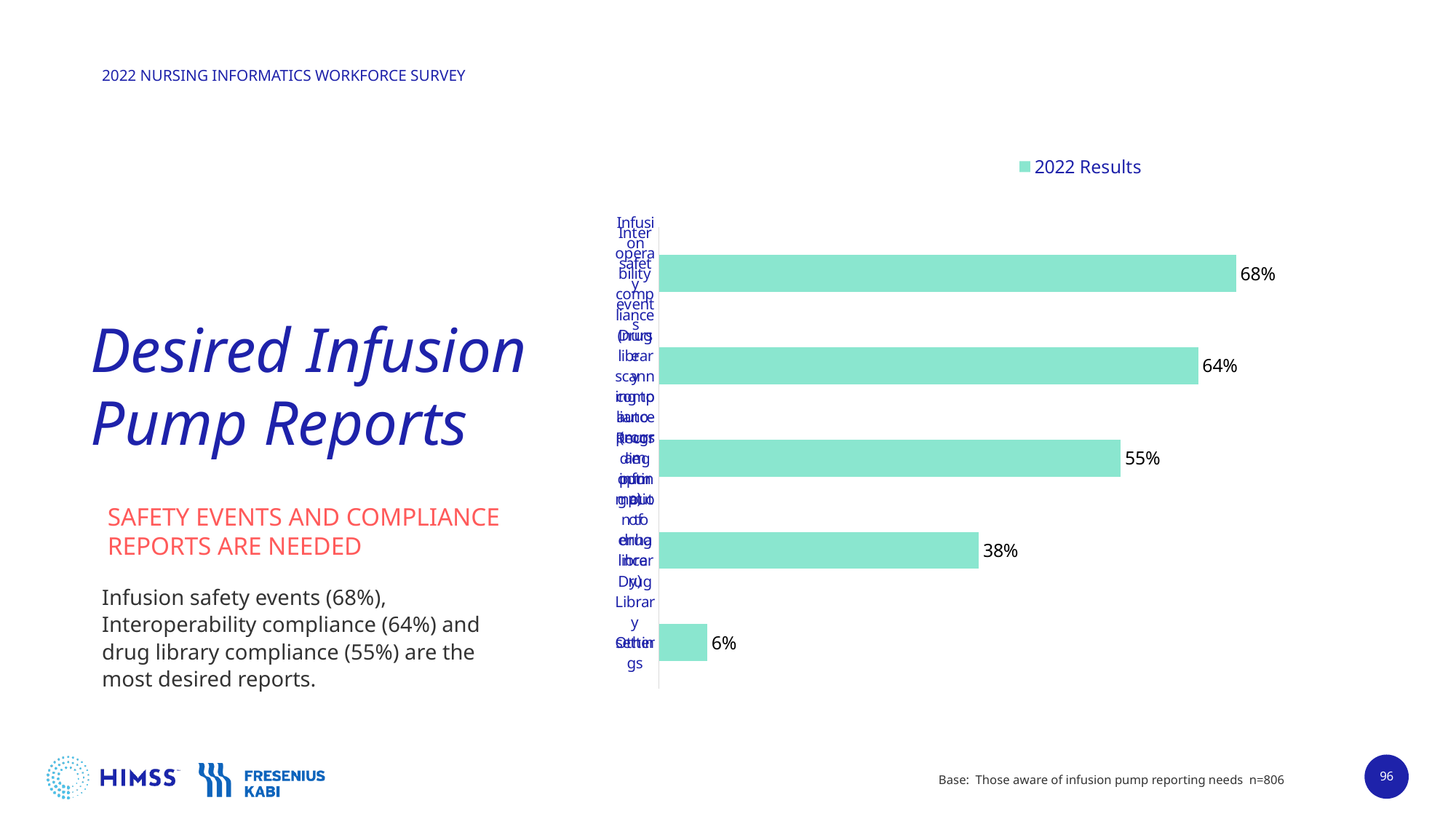
What is the lowest value shown on the chart? 6% What is the highest value shown on the chart? 68% Which is larger: the value for interoperability compliance or the value for drug library compliance? Interoperability compliance How many bars are plotted on the chart? 5 How many percentage points higher is infusion safety events than interoperability compliance? 4 percentage points What percentage of respondents desire infusion safety events reports? 68% What is the difference between the highest and lowest bar values on the chart? 62 percentage points What is the difference between the interoperability compliance value and the drug library compliance value? 9 percentage points What is the value shown for interoperability compliance reports? 64% What type of chart is shown on the slide? Bar chart How many series does the legend list? 1 What percentage is shown for drug library compliance reports? 55%